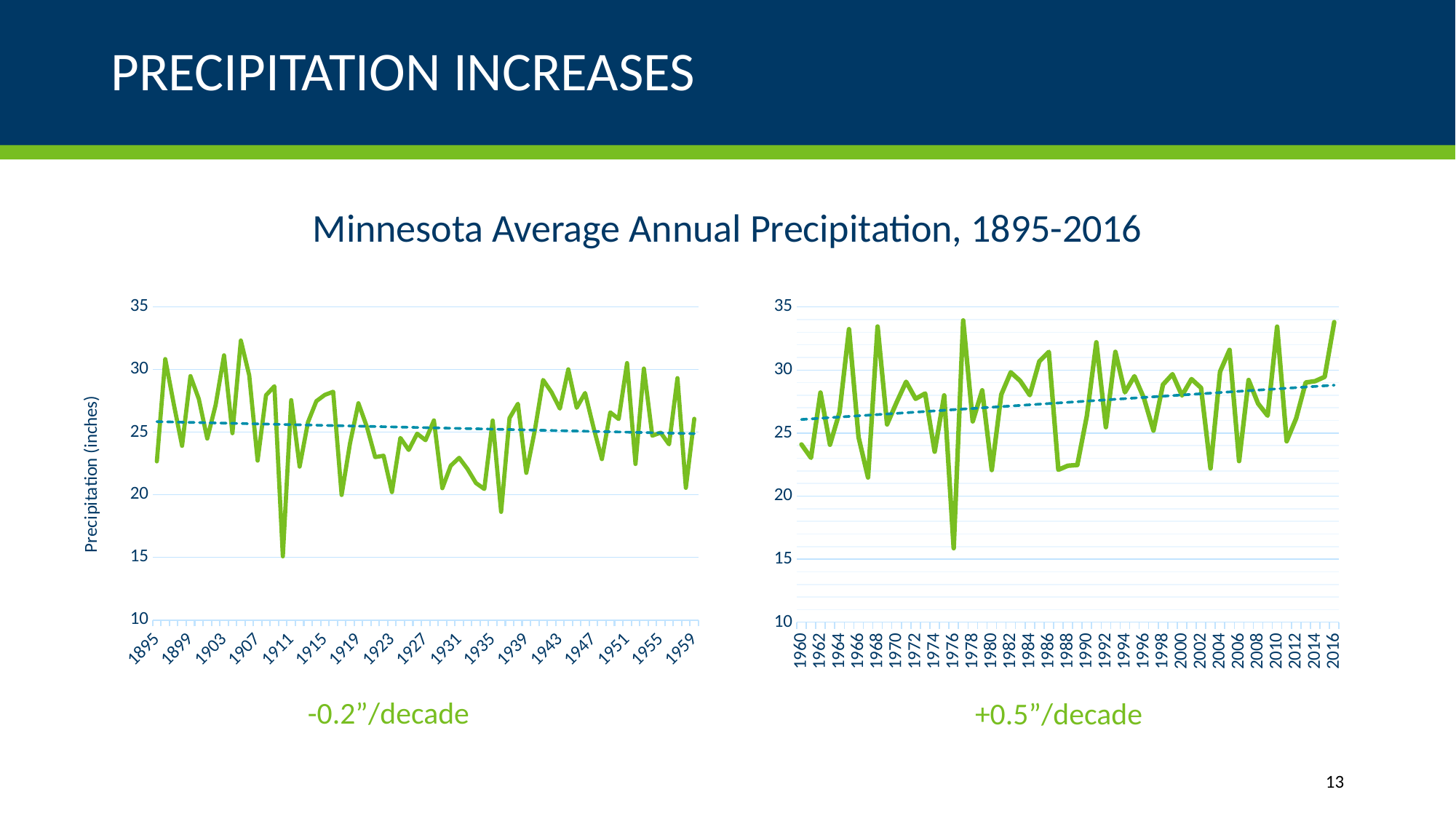
On the left chart (1895-1959), does the dashed trend line rise or fall along the x axis? fall What is the overall title shown above the two charts? Minnesota Average Annual Precipitation, 1895-2016 On the left chart (1895-1959), is the value for 1911 greater or less than 20? greater What kind of chart is the right chart (1960-2016)? line chart On the left chart (1895-1959), which year has the lowest precipitation? 1910 What trend rate per decade is printed below the right chart (1960-2016)? +0.5"/decade On the left chart (1895-1959), is the value for 1895 greater or less than 25? less On the right chart (1960-2016), which year has the lowest precipitation? 1976 On the right chart (1960-2016), does the dashed trend line rise or fall along the x axis? rise On the right chart (1960-2016), is the value for 1976 greater or less than 20? less What kind of chart is the left chart (1895-1959)? line chart